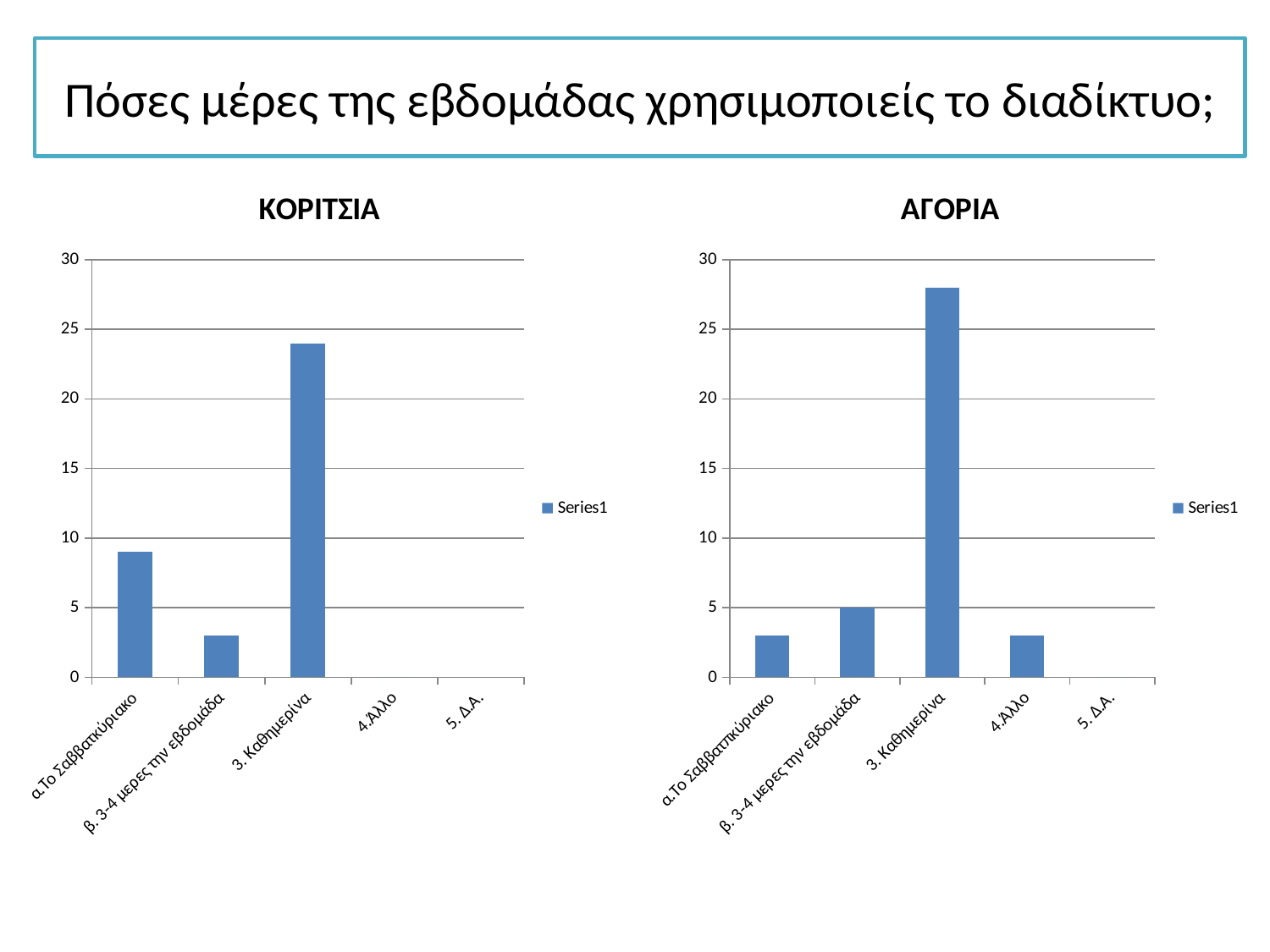
In the ΚΟΡΙΤΣΙΑ chart, is the value for β. 3-4 μερες την εβδομάδα greater or less than 5? less What kind of chart is the ΚΟΡΙΤΣΙΑ chart? bar chart In the ΚΟΡΙΤΣΙΑ chart, is the value for 3. Καθημερινά greater or less than 20? greater In the ΑΓΟΡΙΑ chart, which is larger, the value for β. 3-4 μερες την εβδομάδα or the value for 4.Άλλο? β. 3-4 μερες την εβδομάδα In the ΑΓΟΡΙΑ chart, is the value for α.Το Σαββατκύριακο greater or less than 5? less In the ΑΓΟΡΙΑ chart, which category has the highest value? 3. Καθημερίνα How many categories are shown on the x axis of the ΑΓΟΡΙΑ chart? 5 In the ΚΟΡΙΤΣΙΑ chart, which category has the highest value? 3. Καθημερίνα In the ΚΟΡΙΤΣΙΑ chart, which is larger, the value for α.Το Σαββατκύριακο or the value for β. 3-4 μερες την εβδομάδα? α.Το Σαββατκύριακο How many series does the legend of the ΑΓΟΡΙΑ chart list? 1